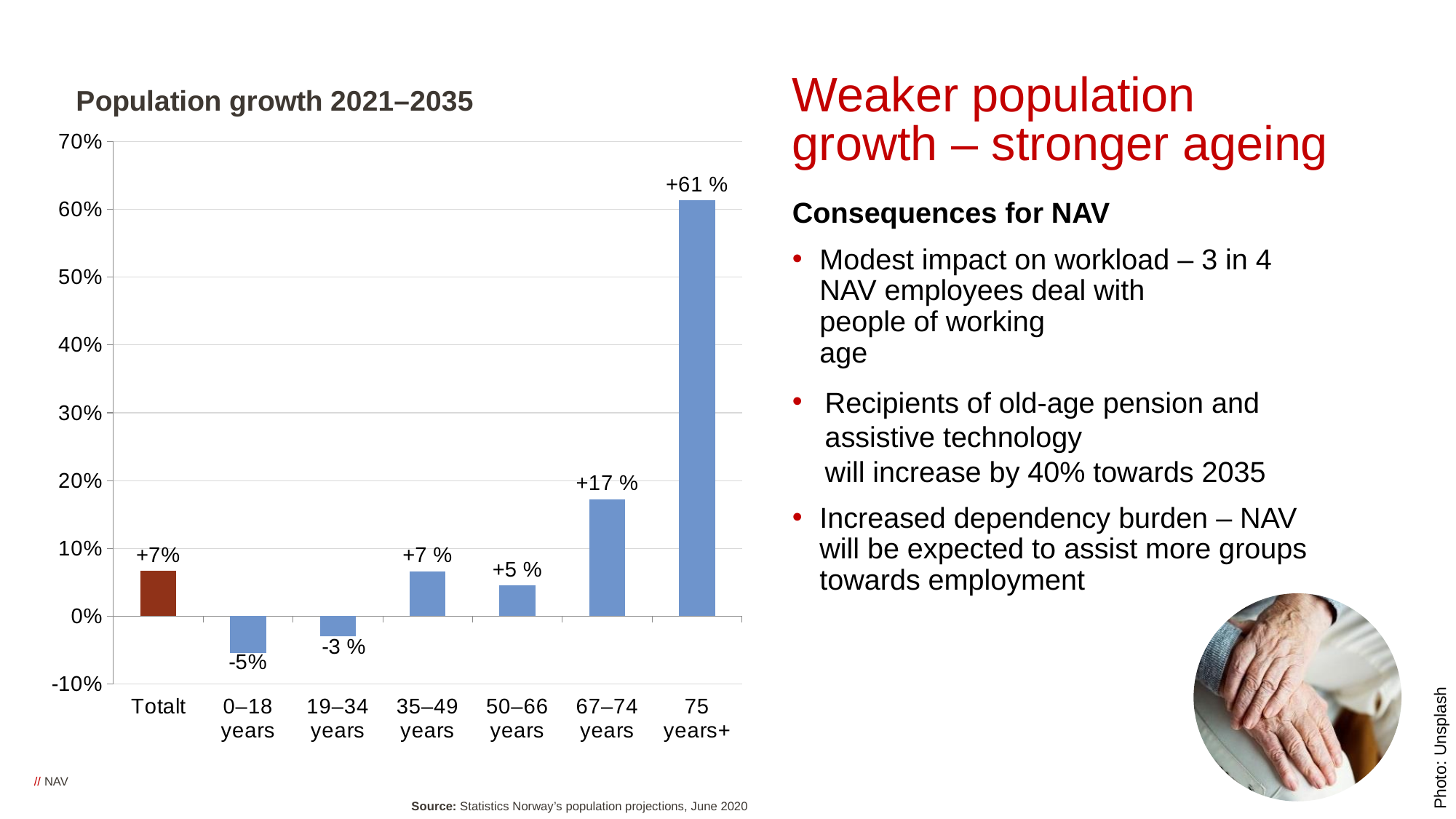
What is the population growth value shown for the 67–74 years group? +17 % What is the difference in percentage points between the growth for 75 years+ and 67–74 years? 44 percentage points What kind of chart is shown on the slide? Bar chart What is the population growth value shown for Totalt? +7% What is the title of the chart? Population growth 2021–2035 What is the population growth value shown for the 0–18 years group? -5% Is the value for 75 years+ greater or less than 60%? greater Which has the larger population growth, 35–49 years or 50–66 years? 35–49 years Which age group has the highest population growth in the chart? 75 years+ What is the population growth value shown for the 75 years+ group? +61 % How many categories are shown on the x axis of the chart? 7 Which age group has the lowest population growth in the chart? 0–18 years